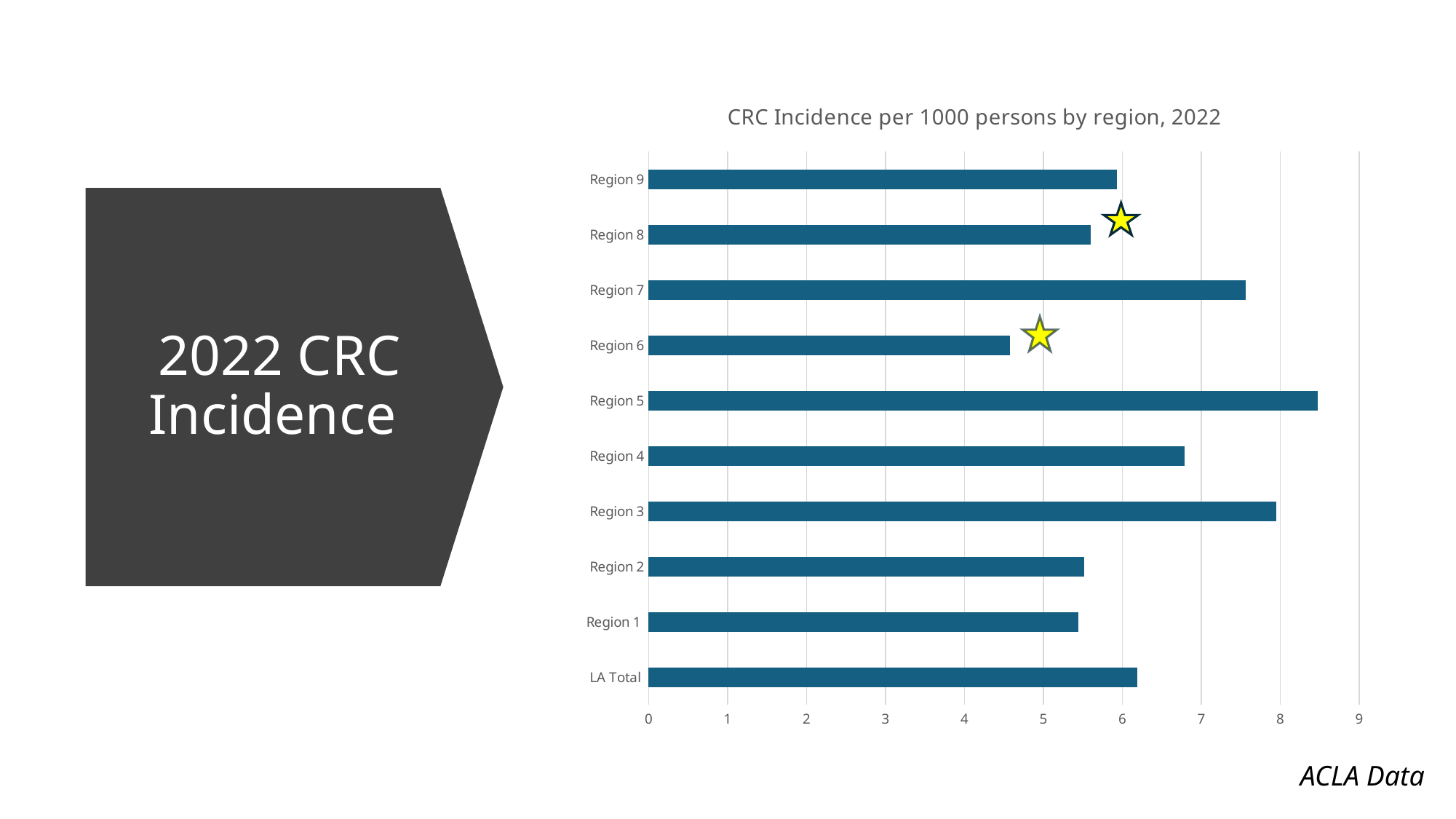
Which region has the lowest CRC incidence per 1000 persons? Region 6 Is the value for Region 6 greater or less than 5? less Which has a higher CRC incidence, Region 8 or Region 6? Region 8 How many categories are plotted in the chart? 10 Which has a higher CRC incidence, Region 7 or Region 4? Region 7 What is the title of the chart? CRC Incidence per 1000 persons by region, 2022 Is the value for Region 5 greater or less than 8? greater What kind of chart is shown on the slide? bar chart Is the value for Region 7 greater or less than 7? greater Which region has the highest CRC incidence per 1000 persons? Region 5